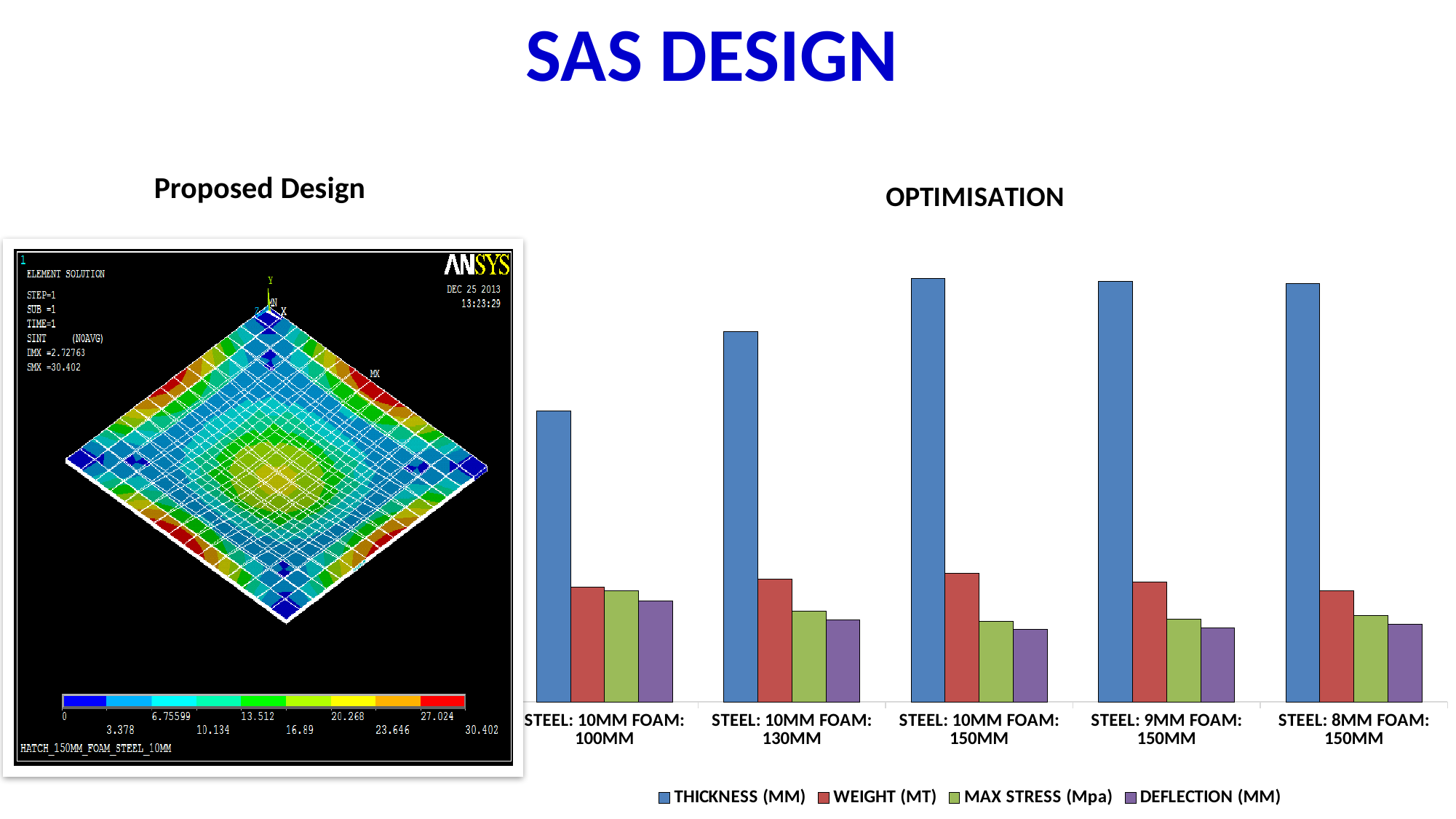
In the OPTIMISATION chart, which category has the highest DEFLECTION (MM) bar? STEEL: 10MM FOAM: 100MM In the OPTIMISATION chart, is MAX STRESS (Mpa) larger for STEEL: 10MM FOAM: 100MM or for STEEL: 10MM FOAM: 150MM? STEEL: 10MM FOAM: 100MM In the OPTIMISATION chart, is THICKNESS (MM) larger for STEEL: 10MM FOAM: 100MM or for STEEL: 10MM FOAM: 130MM? STEEL: 10MM FOAM: 130MM In the OPTIMISATION chart, which colour represents the WEIGHT (MT) series? red In the OPTIMISATION chart, does MAX STRESS (Mpa) rise or fall from STEEL: 10MM FOAM: 100MM to STEEL: 10MM FOAM: 150MM? fall What is the title of the bar chart on the right of the slide? OPTIMISATION How many categories are shown on the x axis of the OPTIMISATION chart? 5 In the OPTIMISATION chart, which category has the lowest THICKNESS (MM) bar? STEEL: 10MM FOAM: 100MM In the OPTIMISATION chart, which category has the highest MAX STRESS (Mpa) bar? STEEL: 10MM FOAM: 100MM How many series does the legend of the OPTIMISATION chart list? 4 What kind of chart is the OPTIMISATION chart? bar chart In the OPTIMISATION chart, which series has the tallest bar in every category? THICKNESS (MM)